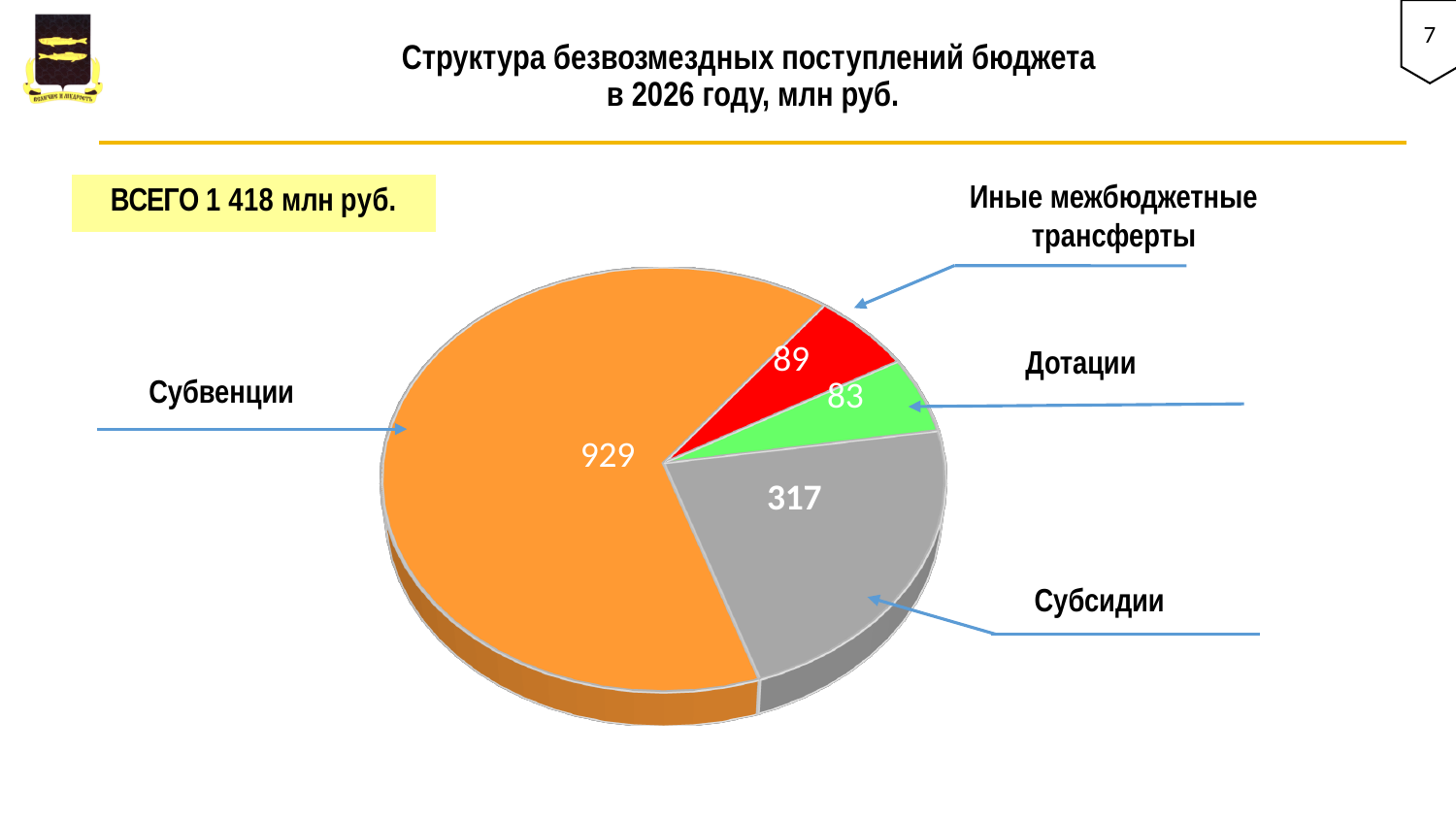
What is the value for Дотации? 83 Which category has the smallest slice of the pie? Дотации What is the title of the chart? Структура безвозмездных поступлений бюджета в 2026 году, млн руб. What is the value for Иные межбюджетные трансферты? 89 How many slices does the pie chart have? 4 Which category has the largest slice of the pie? Субвенции What is the difference between the values for Субвенции and Субсидии? 612 What kind of chart is shown on the slide? pie chart What is the total of all slices as stated on the slide? 1 418 млн руб. Which is larger, Иные межбюджетные трансферты or Дотации? Иные межбюджетные трансферты What is the value for Субсидии? 317 What is the value for Субвенции? 929